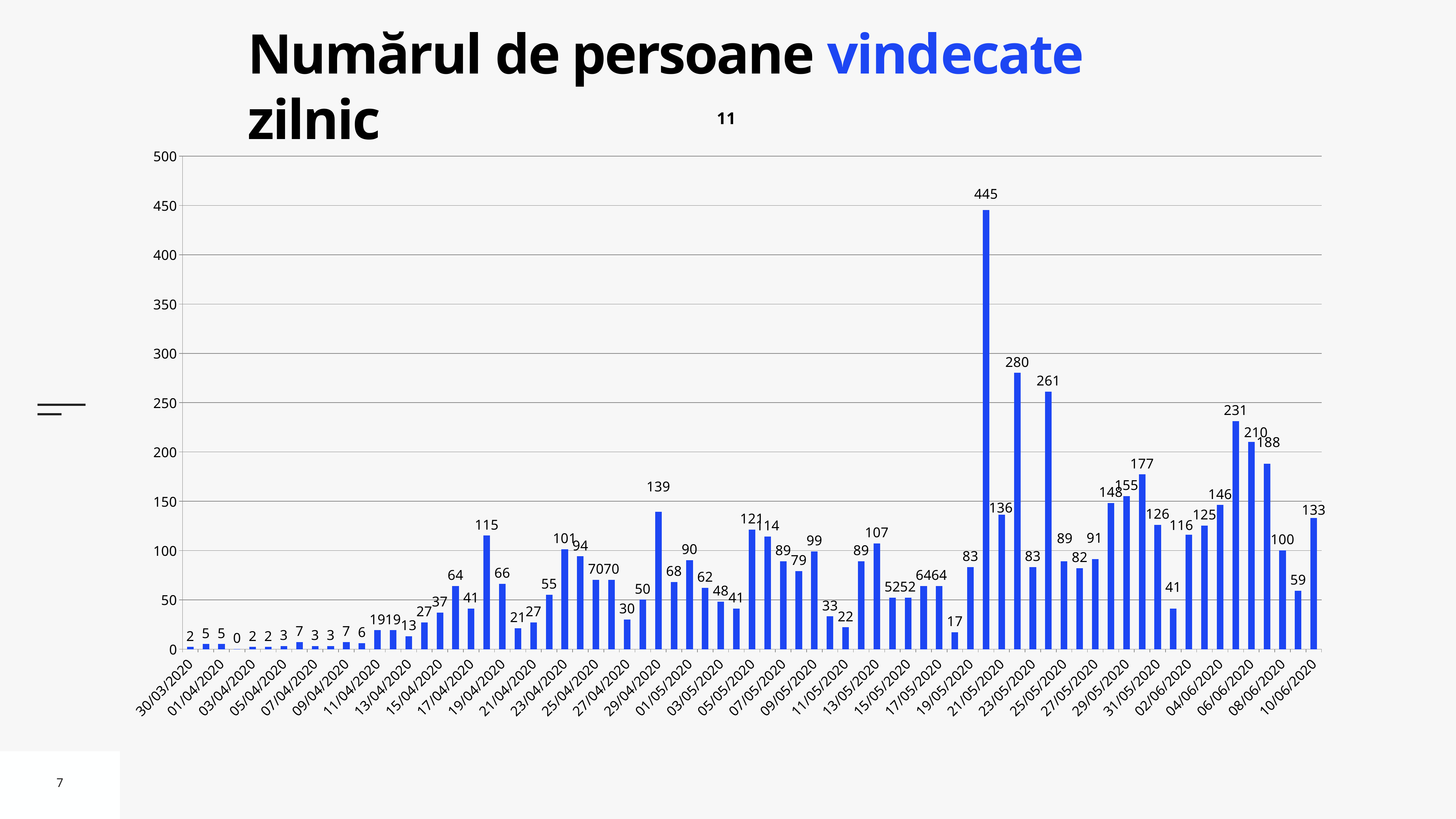
What is the value for 06/06/2020? 210 What kind of chart is shown on the slide? bar chart What is the difference between the values for 29/05/2020 and 31/05/2020? 29 What is the value for 29/04/2020? 139 Which is larger, the value for 04/06/2020 or the value for 02/06/2020? 04/06/2020 What is the value for 23/04/2020? 101 What is the difference between the values for 06/06/2020 and 08/06/2020? 110 Do the values generally rise or fall from 30/03/2020 to 10/06/2020? rise What is the value for 10/06/2020? 133 What is the lowest value shown on the chart? 0 What is the highest value shown on the chart? 445 Which is larger, the value for 05/05/2020 or the value for 13/05/2020? 05/05/2020